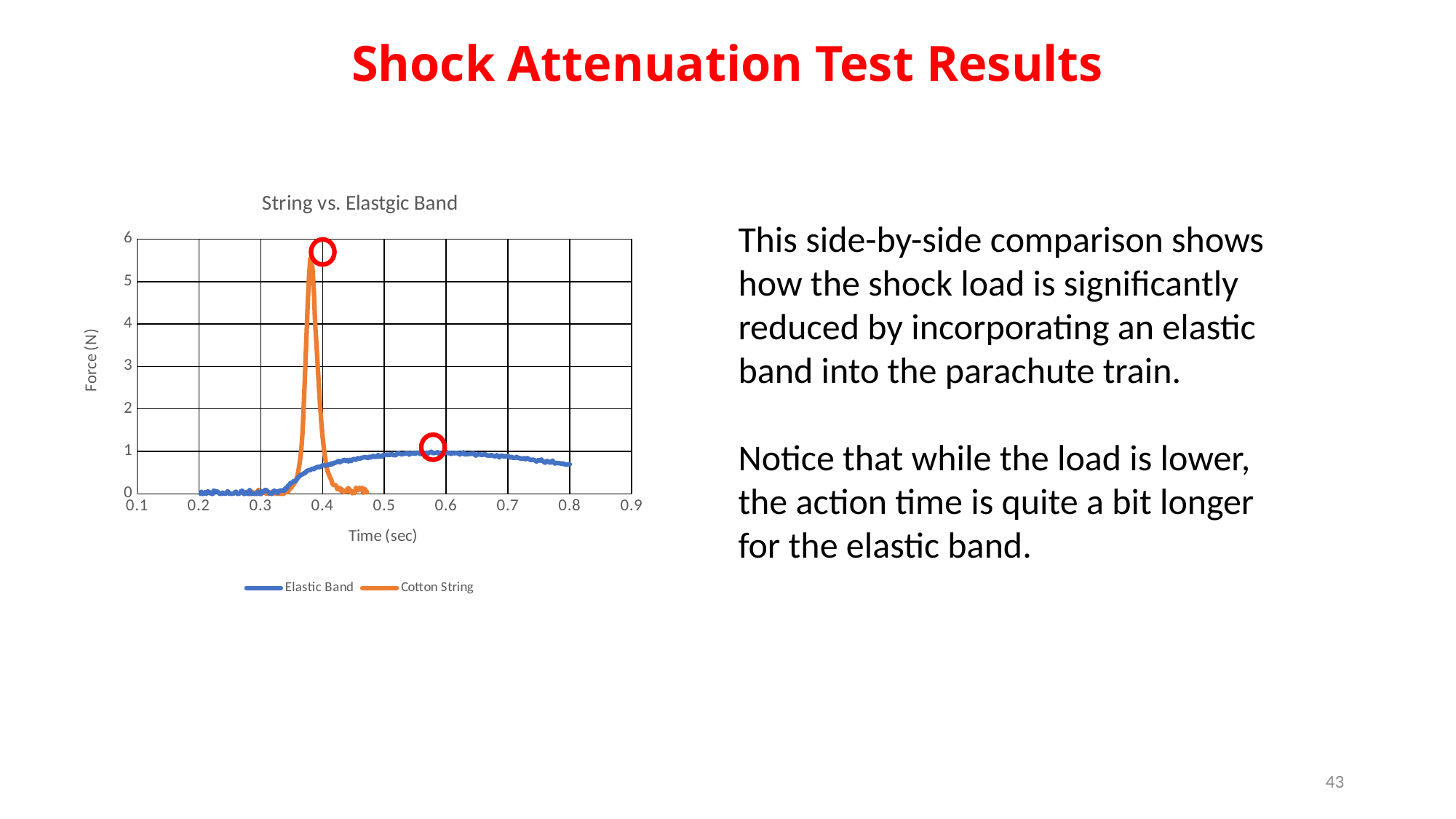
Which series has the lowest peak force? Elastic Band Is the peak force for Cotton String greater or less than 4 N? greater How many series does the chart's legend list? 2 What is the title of the chart? String vs. Elastgic Band Does the Cotton String peak occur before or after 0.4 seconds? before Is the peak force for Elastic Band greater or less than 2 N? less What is the label of the vertical axis of the chart? Force (N) What kind of chart is shown on the slide? line chart Which series reaches the higher peak force, Elastic Band or Cotton String? Cotton String How many tick labels are shown on the Time (sec) axis? 9 Is the peak force for Cotton String greater or less than 5 N? greater What is the highest value shown on the Force (N) axis? 6